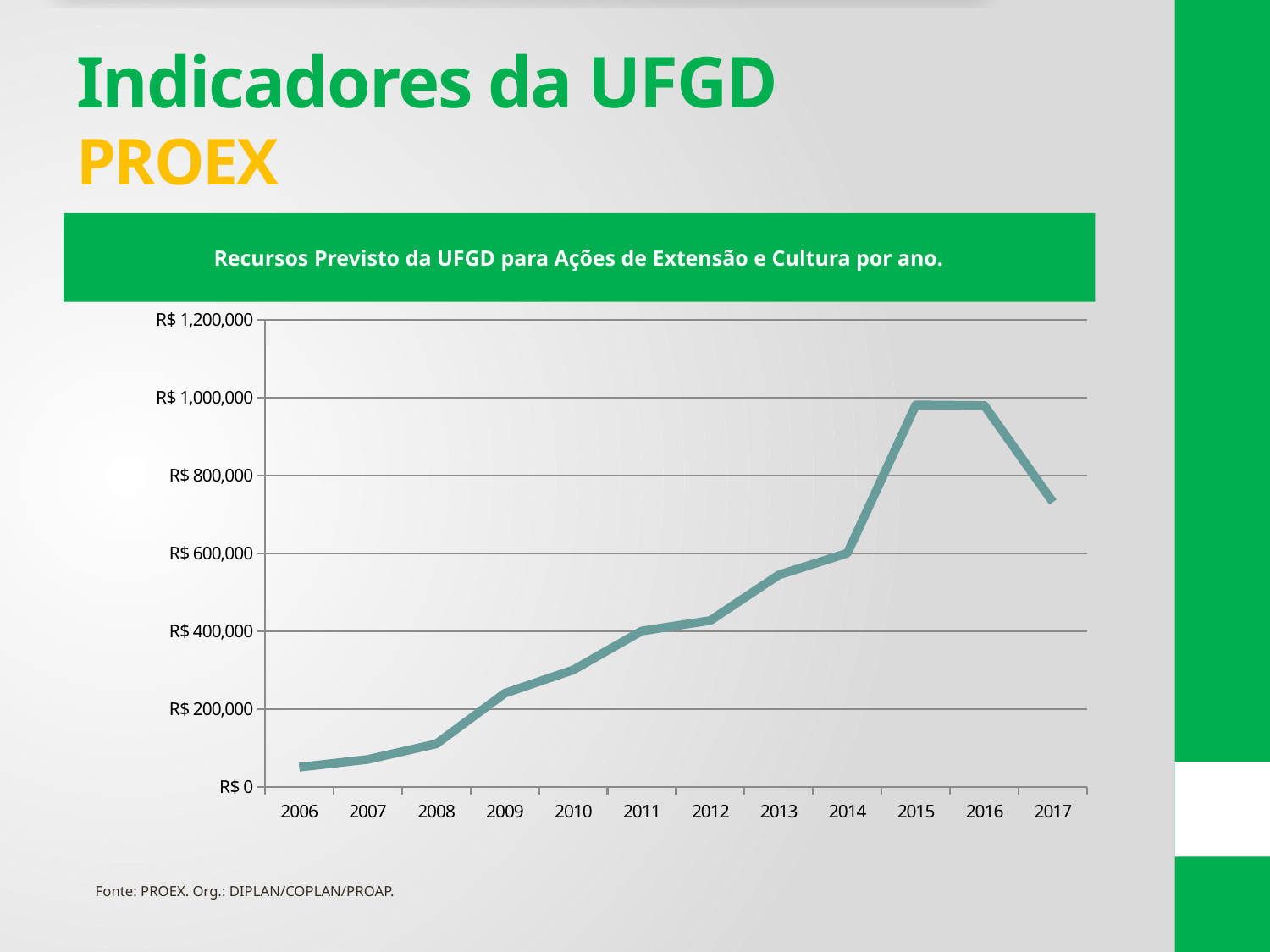
Is the value for 2017 greater or less than R$ 800,000? less Is the value for 2009 greater or less than R$ 200,000? greater Is the value for 2008 greater or less than R$ 200,000? less Do the values rise or fall from 2006 to 2015? rise What is the title of the chart? Recursos Previsto da UFGD para Ações de Extensão e Cultura por ano. Which year has the larger value, 2014 or 2017? 2017 Which year has the larger value, 2010 or 2013? 2013 Which year has the lowest value in the chart? 2006 How many years are plotted on the x axis of the chart? 12 What kind of chart is shown on the slide? line chart